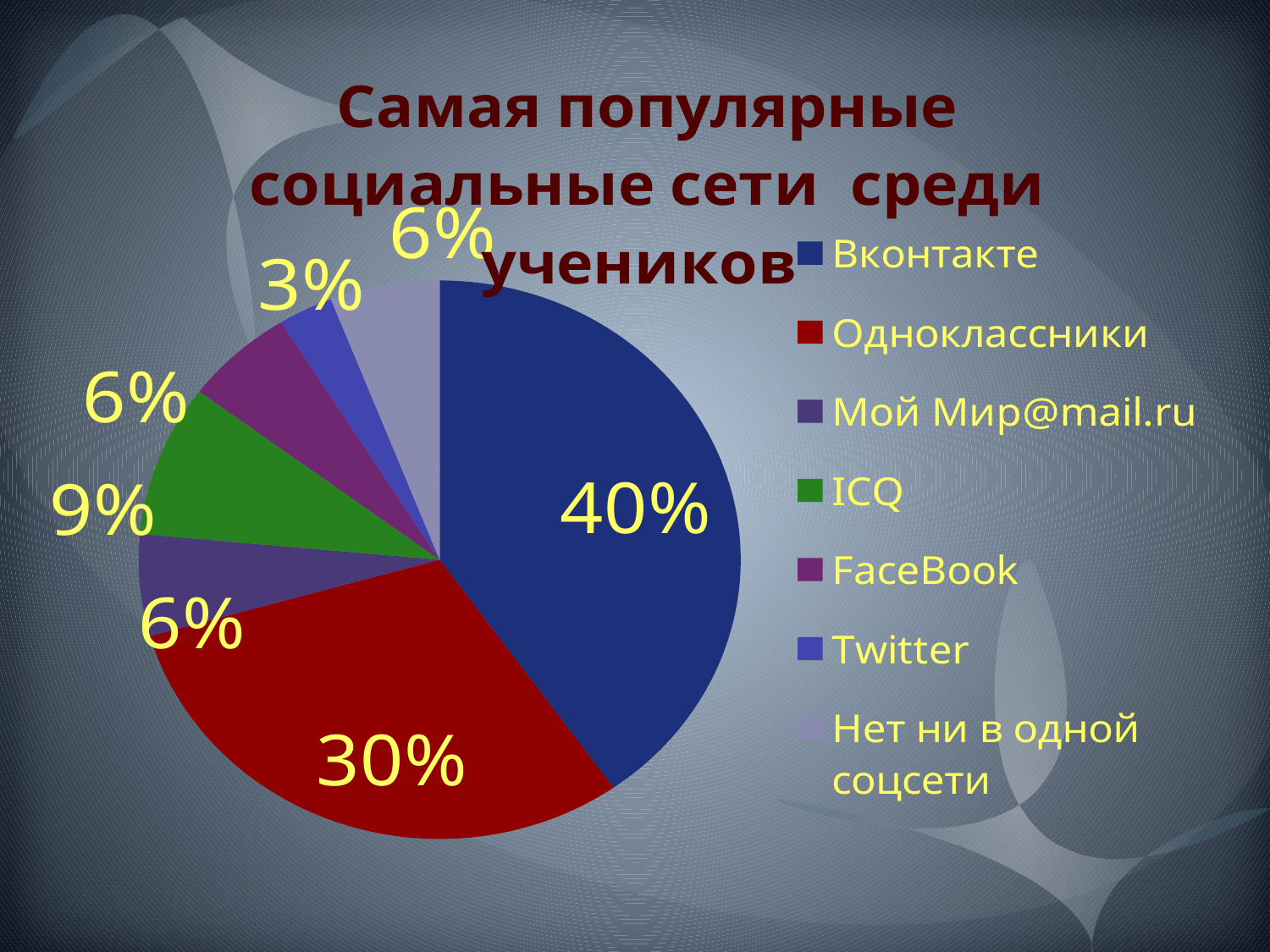
What colour is the slice for Одноклассники? red What is the difference between the shares of Вконтакте and Одноклассники? 10% What share of the pie does Одноклассники have? 30% What share of the pie does ICQ have? 9% Which category has the smallest slice of the pie? Twitter What share of the pie does Twitter have? 3% How many categories does the legend list? 7 What share of the pie does FaceBook have? 6% Which is larger, the share for ICQ or the share for Twitter? ICQ What share of the pie does Вконтакте have? 40% Which social network has the largest slice of the pie? Вконтакте What kind of chart is shown on the slide? pie chart